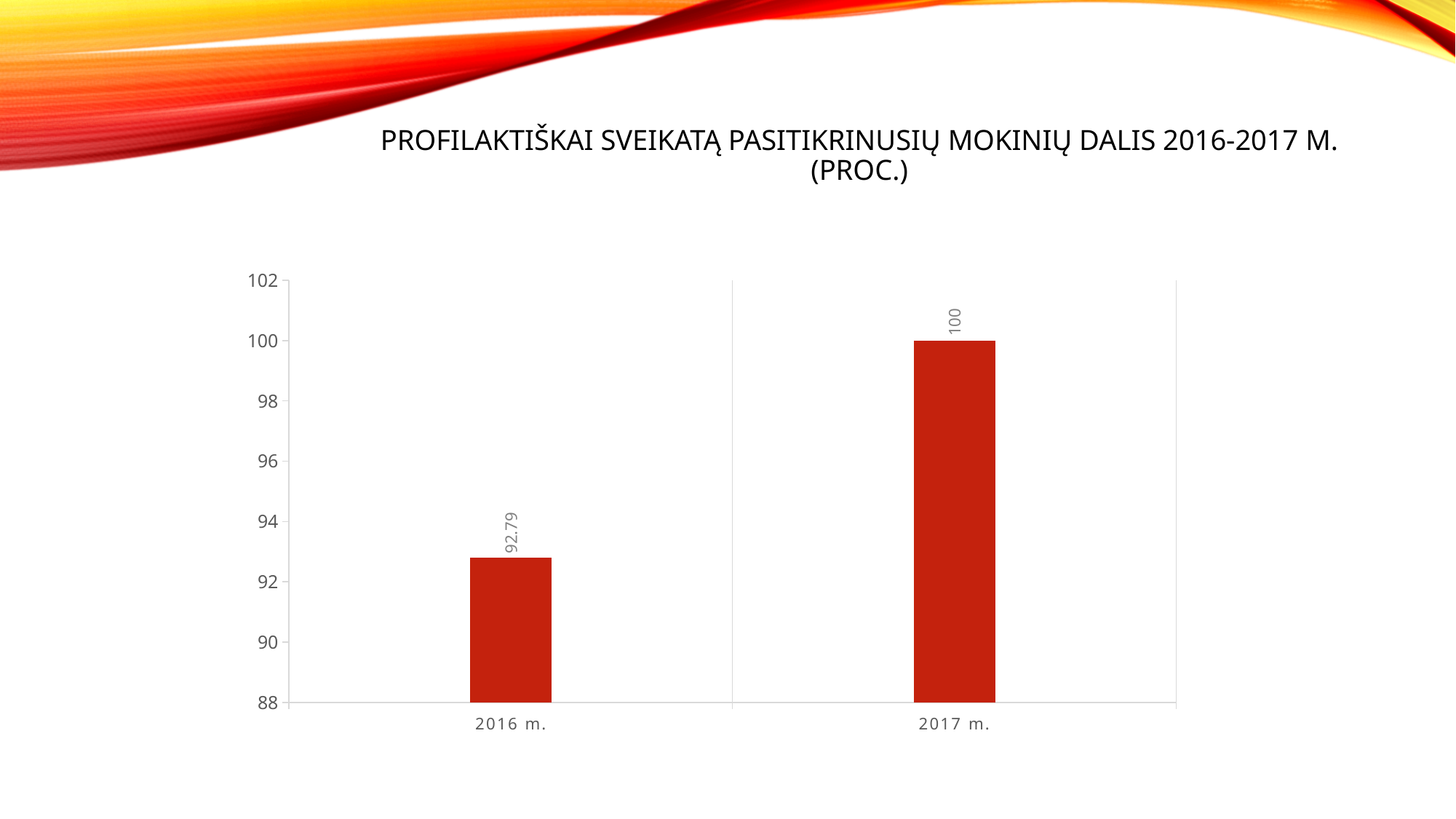
What kind of chart is shown on the slide? bar chart Is the value for 2016 m. greater or less than 94? less Which year has the higher value? 2017 m. What is the difference between the values for 2017 m. and 2016 m.? 7.21 What is the title of the chart? PROFILAKTIŠKAI SVEIKATĄ PASITIKRINUSIŲ MOKINIŲ DALIS 2016-2017 M. (PROC.) What is the value for 2016 m.? 92.79 What colour are the bars in the chart? red Is the value for 2016 m. larger or smaller than the value for 2017 m.? smaller What is the value for 2017 m.? 100 Which year has the lower value? 2016 m. Do the values rise or fall from 2016 m. to 2017 m.? rise How many categories are shown on the x axis? 2